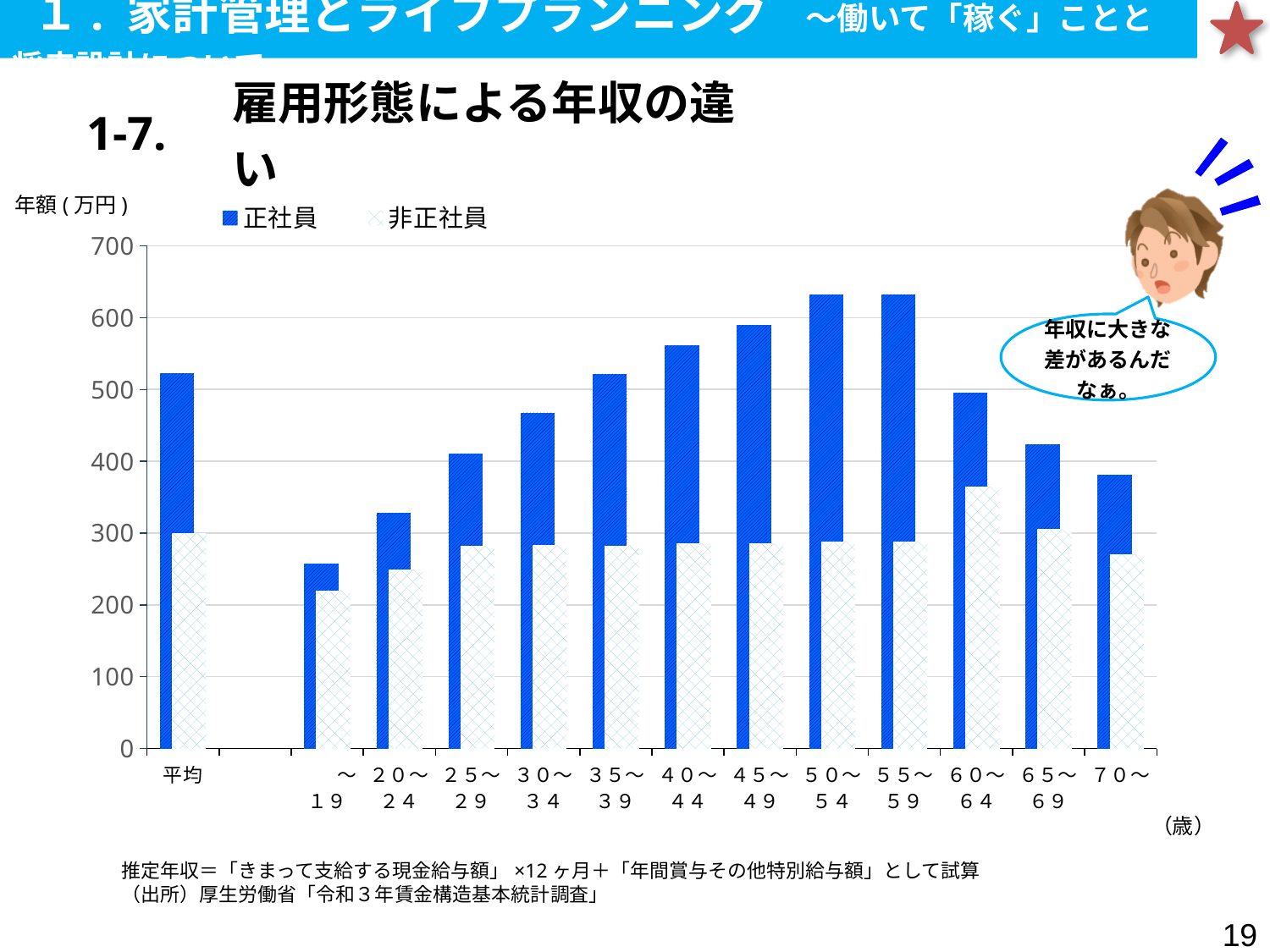
Do the 正社員 values rise or fall from ～19 to 50～54? rise Which age category has the lowest value for 非正社員? ～19 Is the 非正社員 value for 60～64 greater or less than 300? greater Is the 正社員 value for 30～34 greater or less than 500? less Is the 正社員 value for 平均 greater or less than 500? greater What kind of chart is shown on the slide? bar chart How many age categories (including 平均) are shown on the x axis? 13 What are the two series named in the legend? 正社員 and 非正社員 Which age category has the lowest value for 正社員? ～19 Which age category has the highest value for 非正社員? 60～64 How many series does the legend list? 2 For 平均, which is larger: 正社員 or 非正社員? 正社員